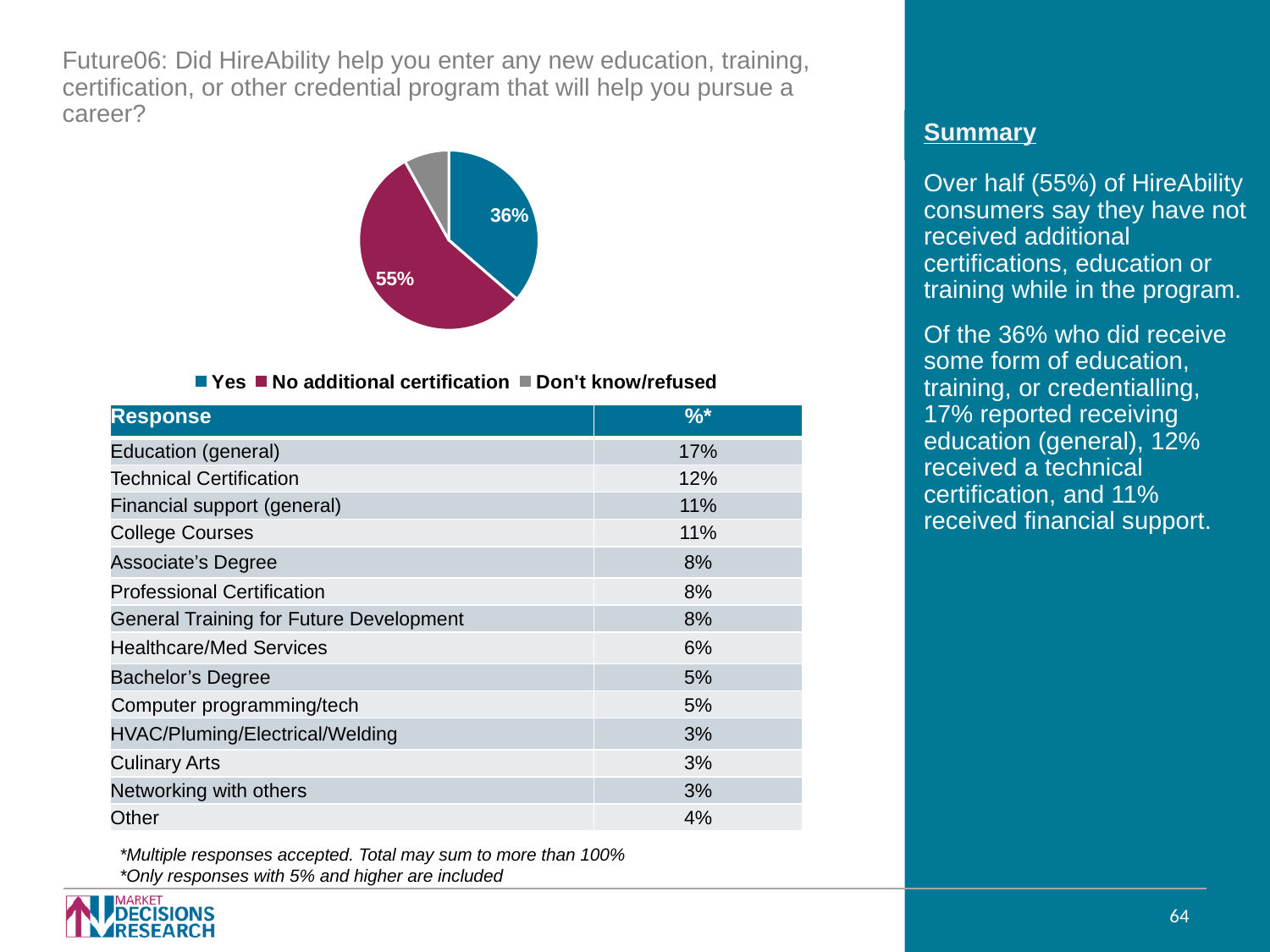
How many entries does the pie chart legend list? 3 By how many percentage points does "No additional certification" exceed "Yes" in the pie chart? 19 percentage points What percentage of respondents answered "Yes" in the pie chart? 36% What colour is the "No additional certification" slice in the pie chart? Magenta/dark red Which response has the smallest slice in the pie chart? Don't know/refused Which response has the largest slice in the pie chart? No additional certification How many slices does the pie chart have? 3 Which legend entry in the pie chart is shown in grey? Don't know/refused What percentage of respondents answered "No additional certification" in the pie chart? 55% Which is larger in the pie chart: the "Yes" slice or the "No additional certification" slice? No additional certification What kind of chart is shown on the slide? Pie chart What share of the pie does the "Yes" slice represent? 36%